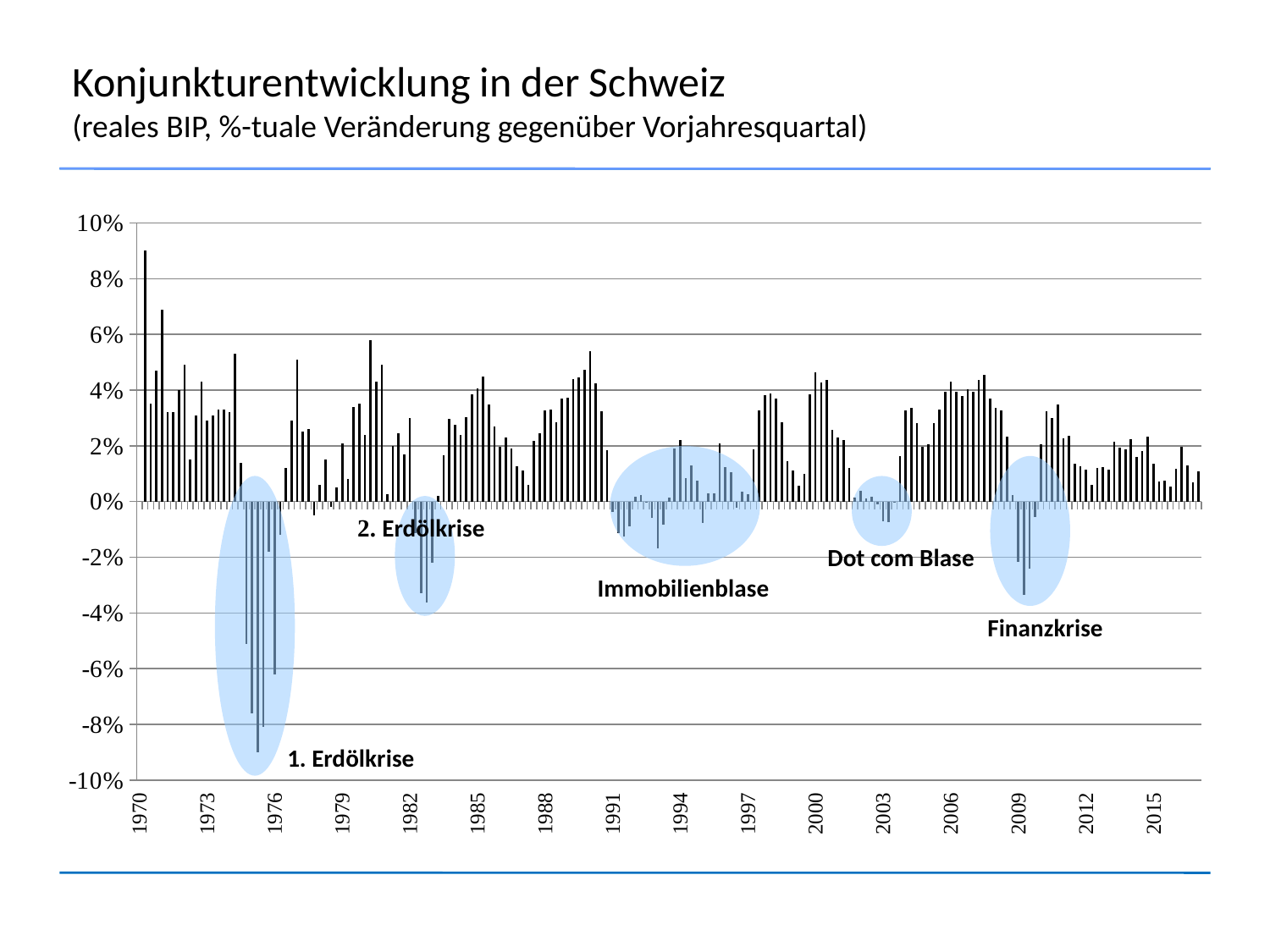
Which labelled crisis period contains the lowest bar on the chart? 1. Erdölkrise What is the title of the chart on the slide? Konjunkturentwicklung in der Schweiz Is the value of the lowest bar in the Finanzkrise period greater or less than -2%? less Is the value of the lowest bar in the 2. Erdölkrise period greater or less than -4%? greater How many crisis periods are highlighted with blue ovals on the chart? 5 In which labelled year does the highest bar on the chart occur? 1970 Is the value of the lowest bar in the 1. Erdölkrise period greater or less than -8%? less Which period has the deeper negative bars, 1. Erdölkrise or 2. Erdölkrise? 1. Erdölkrise What kind of chart is shown on the slide? bar chart